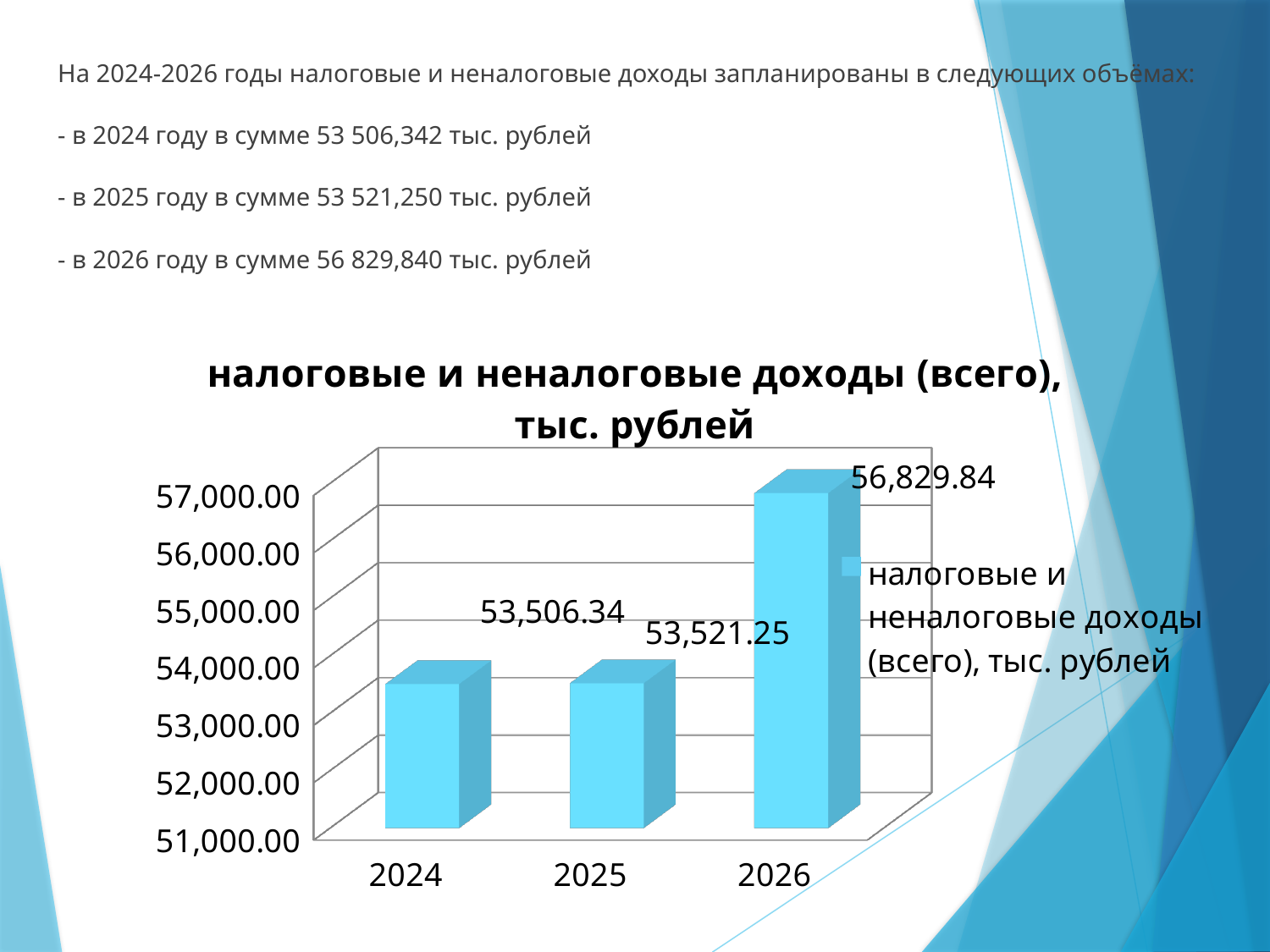
Do the values rise or fall from 2024 to 2026? rise How many years are shown on the x axis of the chart? 3 What is the value for 2025 in the chart? 53,521.25 What is the difference between the values for 2025 and 2024? 14.91 What kind of chart is shown on the slide? bar chart Which year has the highest value in the chart? 2026 What is the value for 2024 in the chart? 53,506.34 What is the value for 2026 in the chart? 56,829.84 Is the value for 2026 greater or less than 56,000.00? greater Which is larger, the value for 2026 or the value for 2024? 2026 Which year has the lowest value in the chart? 2024 What is the difference between the values for 2026 and 2025? 3,308.59